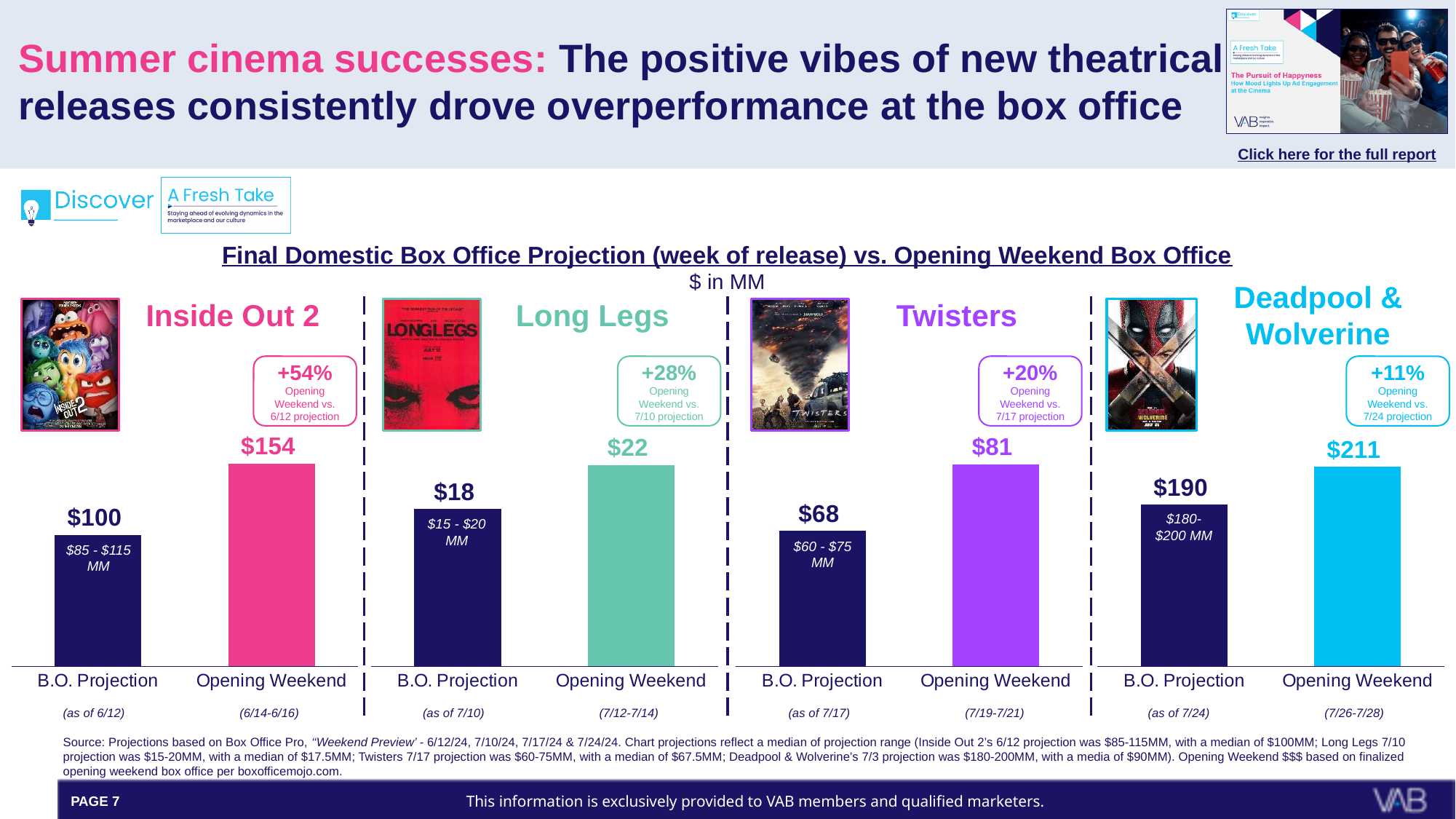
In the Twisters chart, what is the value of the Opening Weekend bar? $81 In the Deadpool & Wolverine chart, what is the value of the B.O. Projection bar? $190 What kind of chart is used for Inside Out 2? Bar chart In the Inside Out 2 chart, what is the difference between the Opening Weekend and B.O. Projection values? $54 What unit is stated under the chart title 'Final Domestic Box Office Projection (week of release) vs. Opening Weekend Box Office'? $ in MM In the Twisters chart, which bar is taller, B.O. Projection or Opening Weekend? Opening Weekend In the Long Legs chart, what is the value of the B.O. Projection bar? $18 How many bars does the Twisters chart have? 2 In the Inside Out 2 chart, what is the value of the Opening Weekend bar? $154 In the Long Legs chart, which bar is lower, B.O. Projection or Opening Weekend? B.O. Projection In the Long Legs chart, what percentage change is shown for Opening Weekend vs. the 7/10 projection? +28% In the Deadpool & Wolverine chart, what is the difference between the Opening Weekend and B.O. Projection values? $21